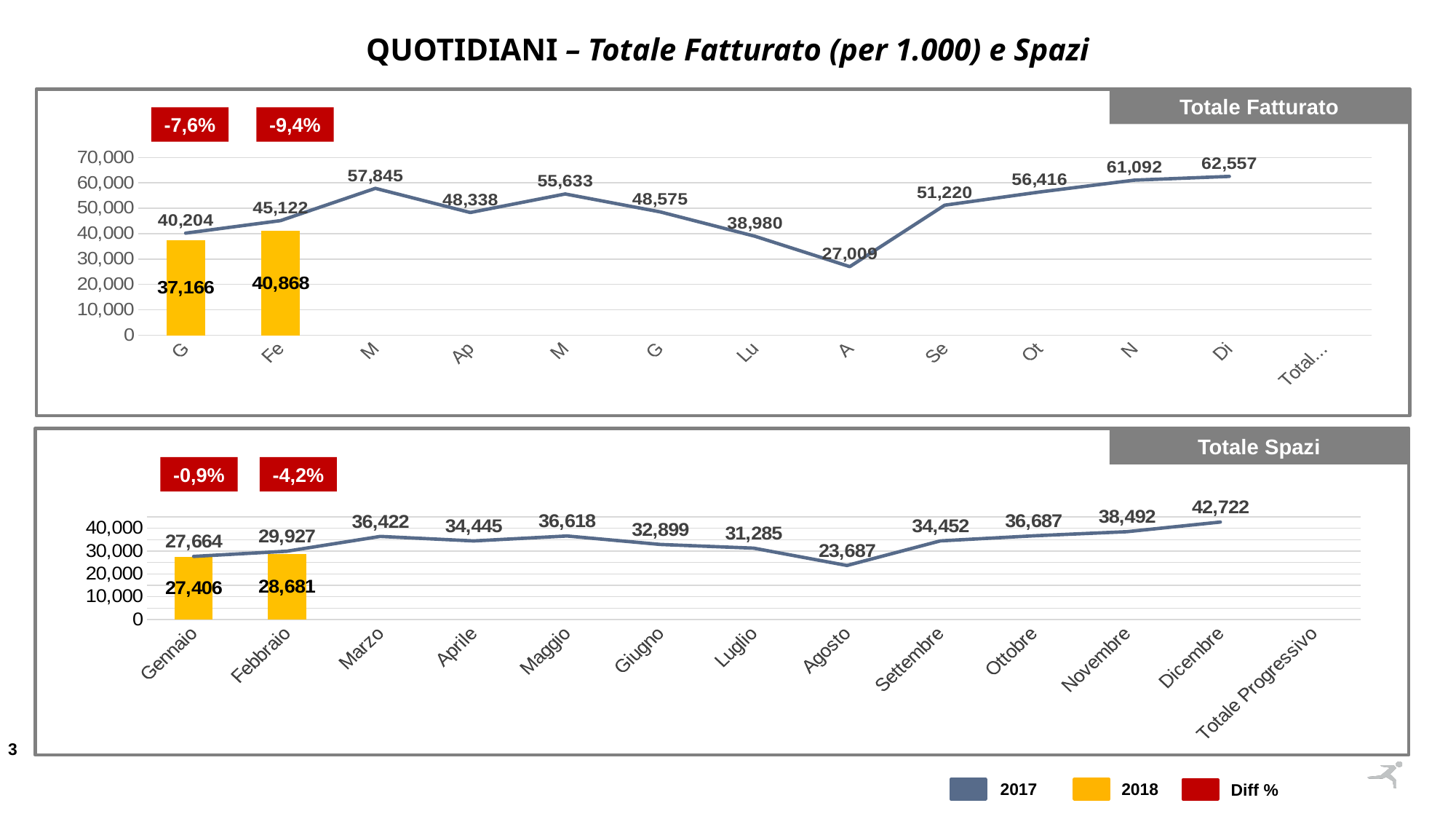
In the Totale Fatturato chart, what is the 2017 value for the last month (Di)? 62,557 In the Totale Spazi chart, what is the difference between the 2017 value (29,927) and the 2018 value (28,681) for Febbraio? 1,246 In the Totale Fatturato chart, what Diff % is shown above the second category (Fe)? -9,4% In the Totale Fatturato chart, what is the 2017 value for the third category (labelled M, Marzo)? 57,845 In the Totale Spazi chart, which month has the highest 2017 value? Dicembre In the Totale Fatturato chart, what is the difference between the 2017 value (40,204) and the 2018 value (37,166) for the first category (G)? 3,038 In the Totale Spazi chart, which has the larger 2017 value, Marzo or Maggio? Maggio In the Totale Spazi chart, what is the 2018 value for Gennaio? 27,406 How many series does the legend at the bottom of the slide list? 3 In the Totale Spazi chart, what is the 2017 value for Agosto? 23,687 In the Totale Fatturato chart, what is the 2018 value for the second category (Fe)? 40,868 In the Totale Fatturato chart, what is the lowest 2017 value shown on the line? 27,009